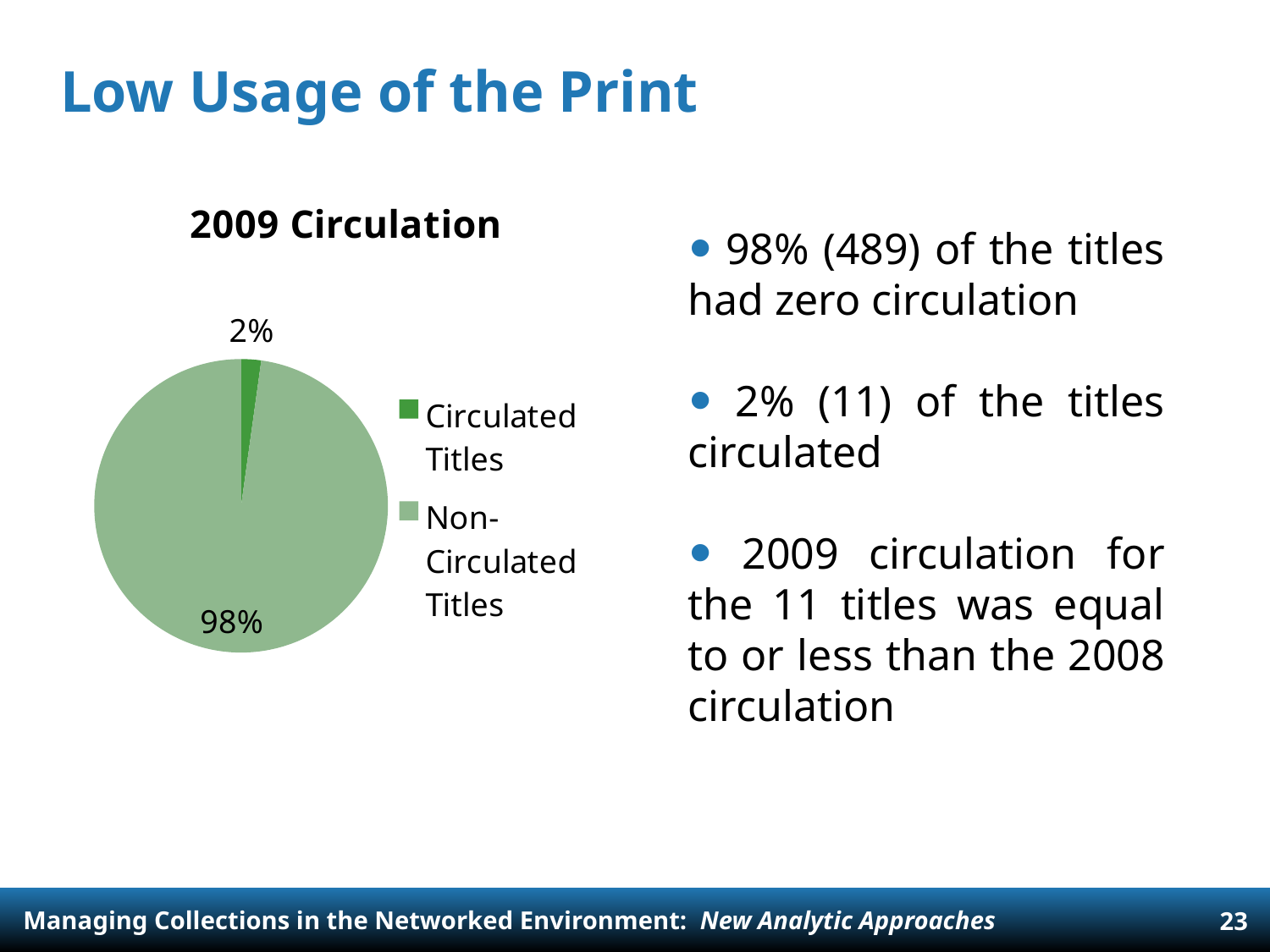
What share of the pie is Circulated Titles? 2% What is the difference in percentage points between the Non-Circulated Titles slice and the Circulated Titles slice? 96 What kind of chart is shown on the slide? pie chart What share of the pie is Non-Circulated Titles? 98% Which legend entry is shown in the darker green colour? Circulated Titles How many slices does the pie chart have? 2 Which is larger, the Circulated Titles slice or the Non-Circulated Titles slice? Non-Circulated Titles What is the title of the chart? 2009 Circulation Which slice of the pie is the largest? Non-Circulated Titles Which slice of the pie is the smallest? Circulated Titles How many entries does the legend list? 2